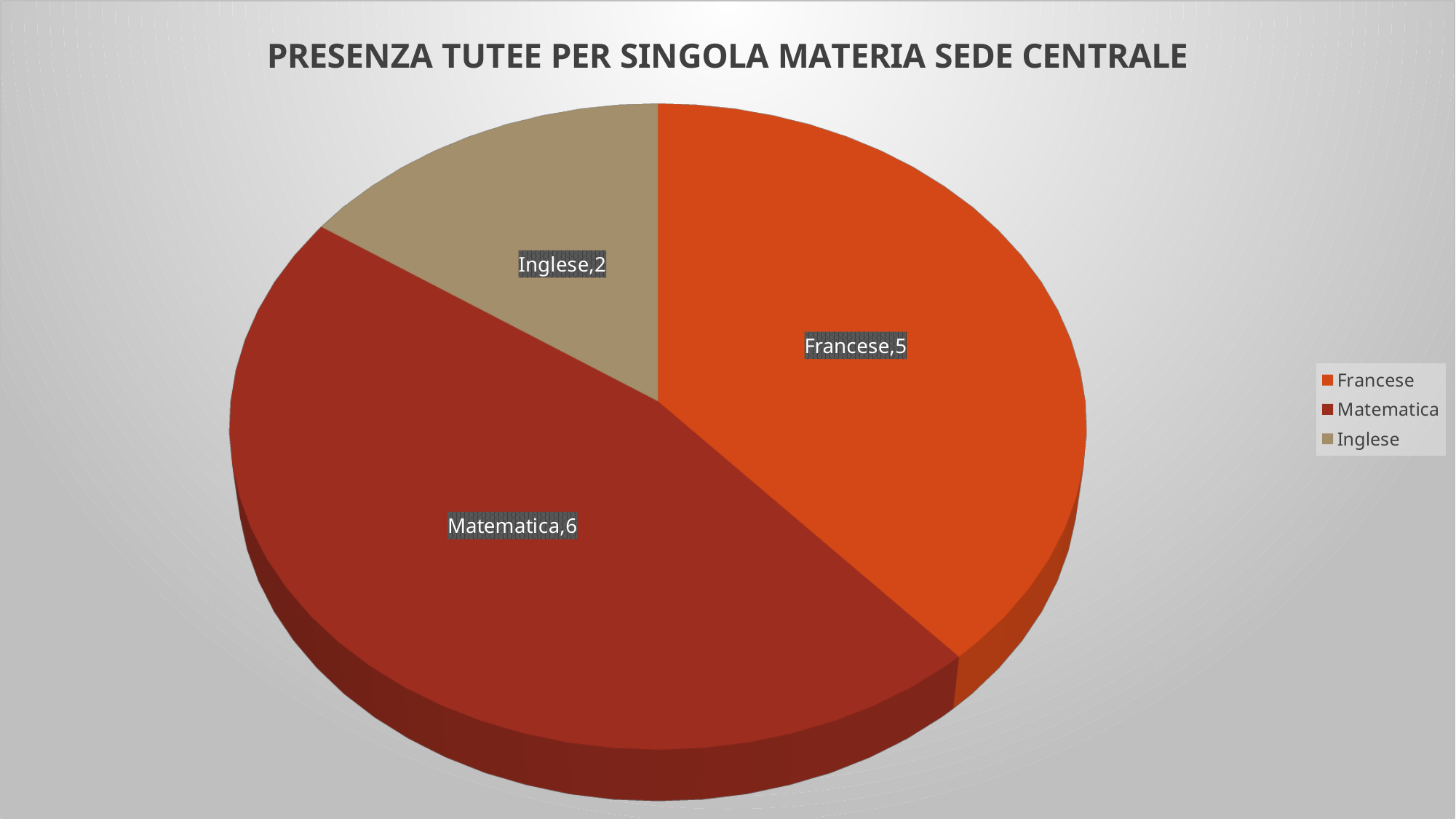
What is the total of all slices in the pie chart? 13 What is the value for Inglese? 2 Which category has the largest slice? Matematica Which category has the smallest slice? Inglese What is the title of the chart? PRESENZA TUTEE PER SINGOLA MATERIA SEDE CENTRALE Which is larger, the value for Francese or the value for Inglese? Francese What is the difference between the values for Matematica and Inglese? 4 How many categories are shown in the pie chart? 3 Which category is shown in orange in the legend? Francese What is the value for Matematica? 6 What kind of chart is shown on the slide? Pie chart What is the value for Francese? 5